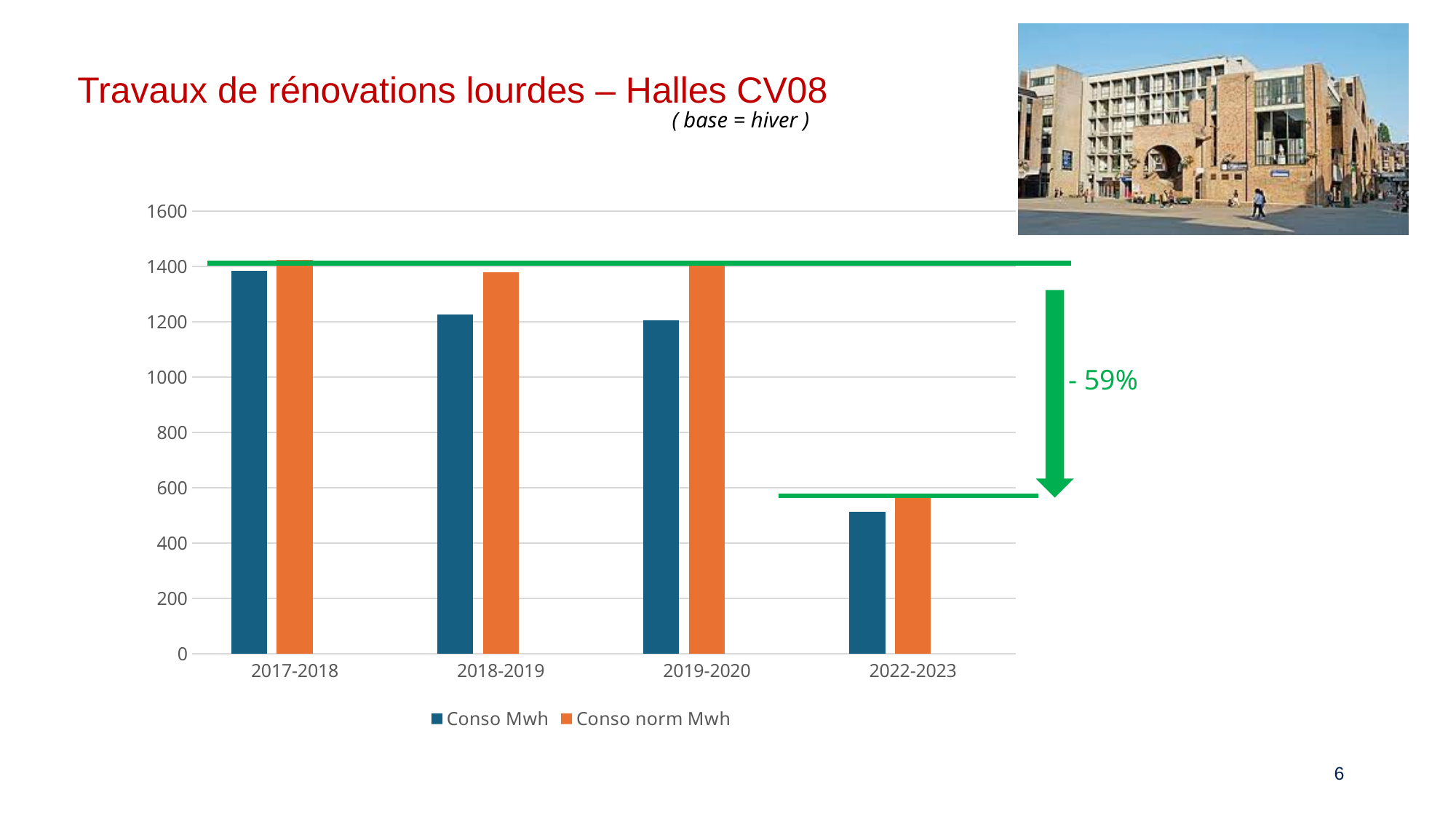
In which period is the Conso Mwh value highest? 2017-2018 Is the Conso norm Mwh value for 2018-2019 greater or less than 1200? greater In which period is the Conso norm Mwh value lowest? 2022-2023 How many series does the chart legend list? 2 In which period is the Conso Mwh value lowest? 2022-2023 How many periods are shown on the x axis of the chart? 4 For 2018-2019, which is larger: Conso Mwh or Conso norm Mwh? Conso norm Mwh Does the Conso Mwh value rise or fall from 2017-2018 to 2022-2023? fall What percentage change is annotated next to the green arrow on the chart? - 59% Is the Conso Mwh value for 2022-2023 greater or less than 600? less What kind of chart is shown on the slide? bar chart Which series are listed in the chart legend? Conso Mwh and Conso norm Mwh